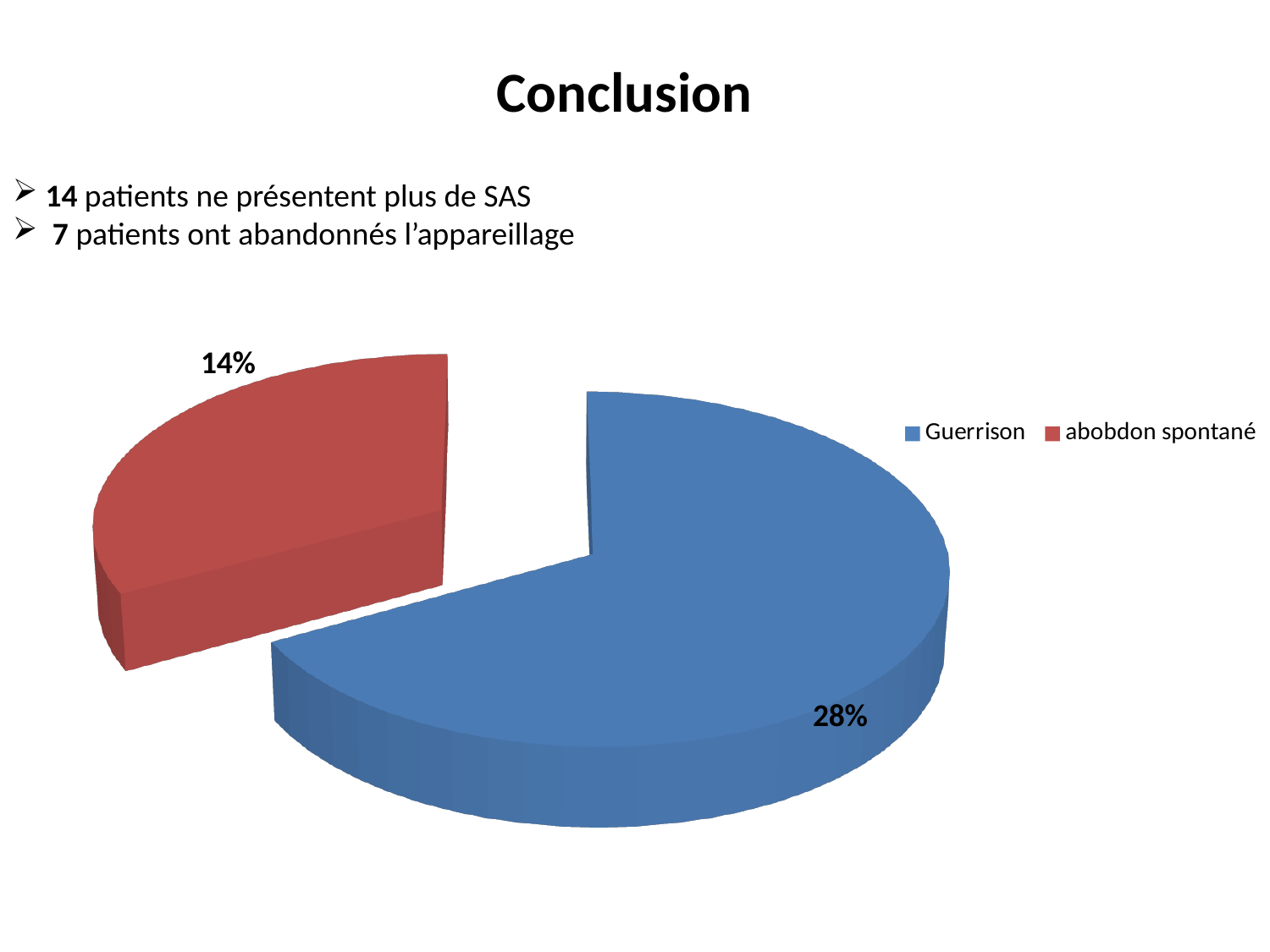
How many slices does the pie chart have? 2 What percentage label is shown on the abobdon spontané slice of the pie chart? 14% What colour is the abobdon spontané slice in the pie chart? Red Which category has the largest slice in the pie chart? Guerrison What colour is the Guerrison slice in the pie chart? Blue What is the difference between the labelled values of the Guerrison and abobdon spontané slices? 14% Which slice is larger, Guerrison or abobdon spontané? Guerrison Which category has the smallest slice in the pie chart? abobdon spontané What percentage label is shown on the Guerrison slice of the pie chart? 28% How many entries does the legend of the pie chart list? 2 What kind of chart is shown on the slide? Pie chart